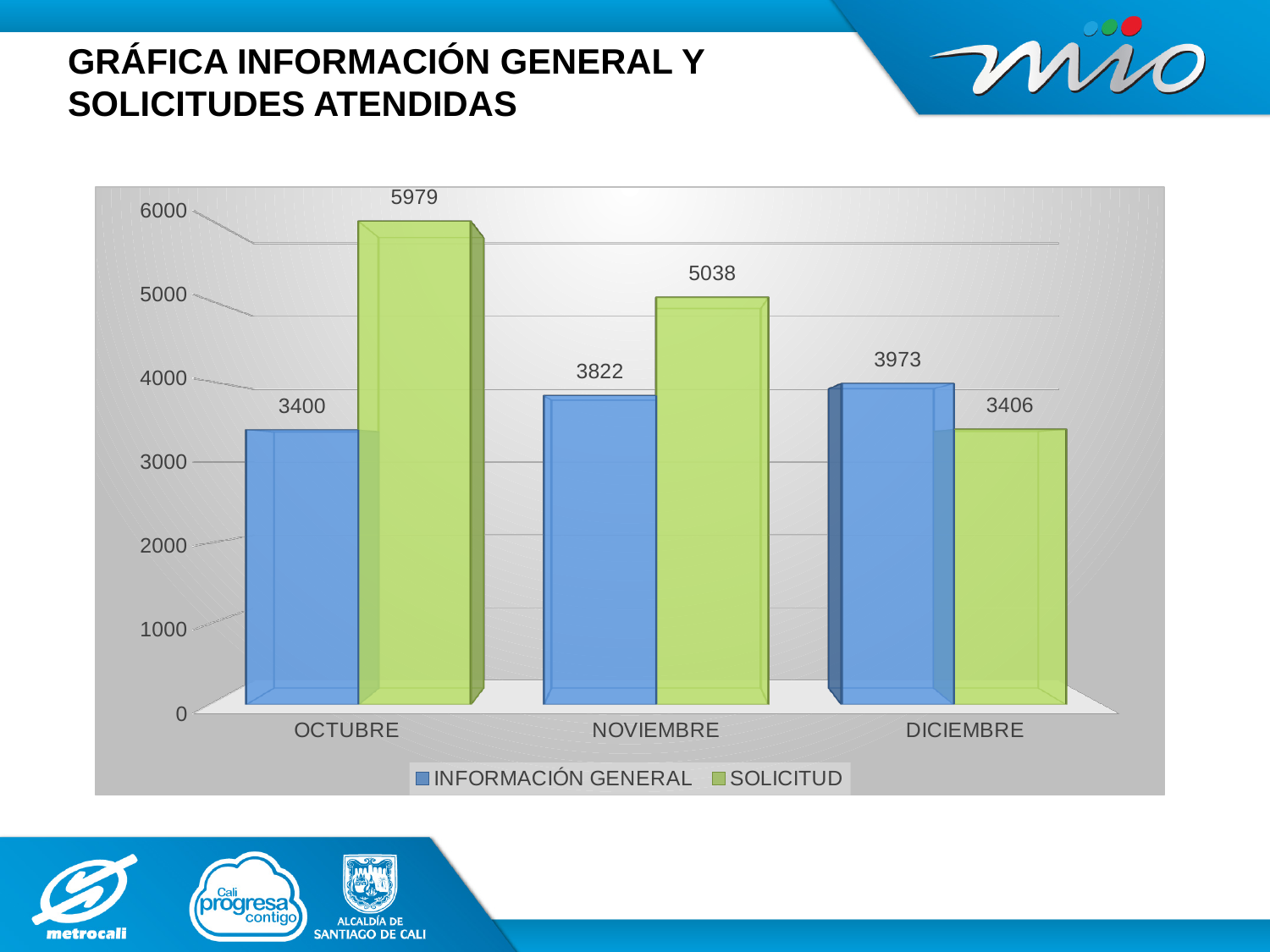
Does the SOLICITUD value rise or fall from OCTUBRE to DICIEMBRE? Fall What is the value for SOLICITUD in NOVIEMBRE? 5038 What is the value for INFORMACIÓN GENERAL in DICIEMBRE? 3973 What is the value for INFORMACIÓN GENERAL in OCTUBRE? 3400 How many months are shown on the x axis? 3 In which month is the INFORMACIÓN GENERAL value lowest? OCTUBRE How many series does the legend list? 2 Which colour represents the SOLICITUD series? Green Which is larger in DICIEMBRE, INFORMACIÓN GENERAL or SOLICITUD? INFORMACIÓN GENERAL What is the difference between SOLICITUD and INFORMACIÓN GENERAL in OCTUBRE? 2579 In which month is the SOLICITUD value highest? OCTUBRE What kind of chart is shown on the slide? Bar chart